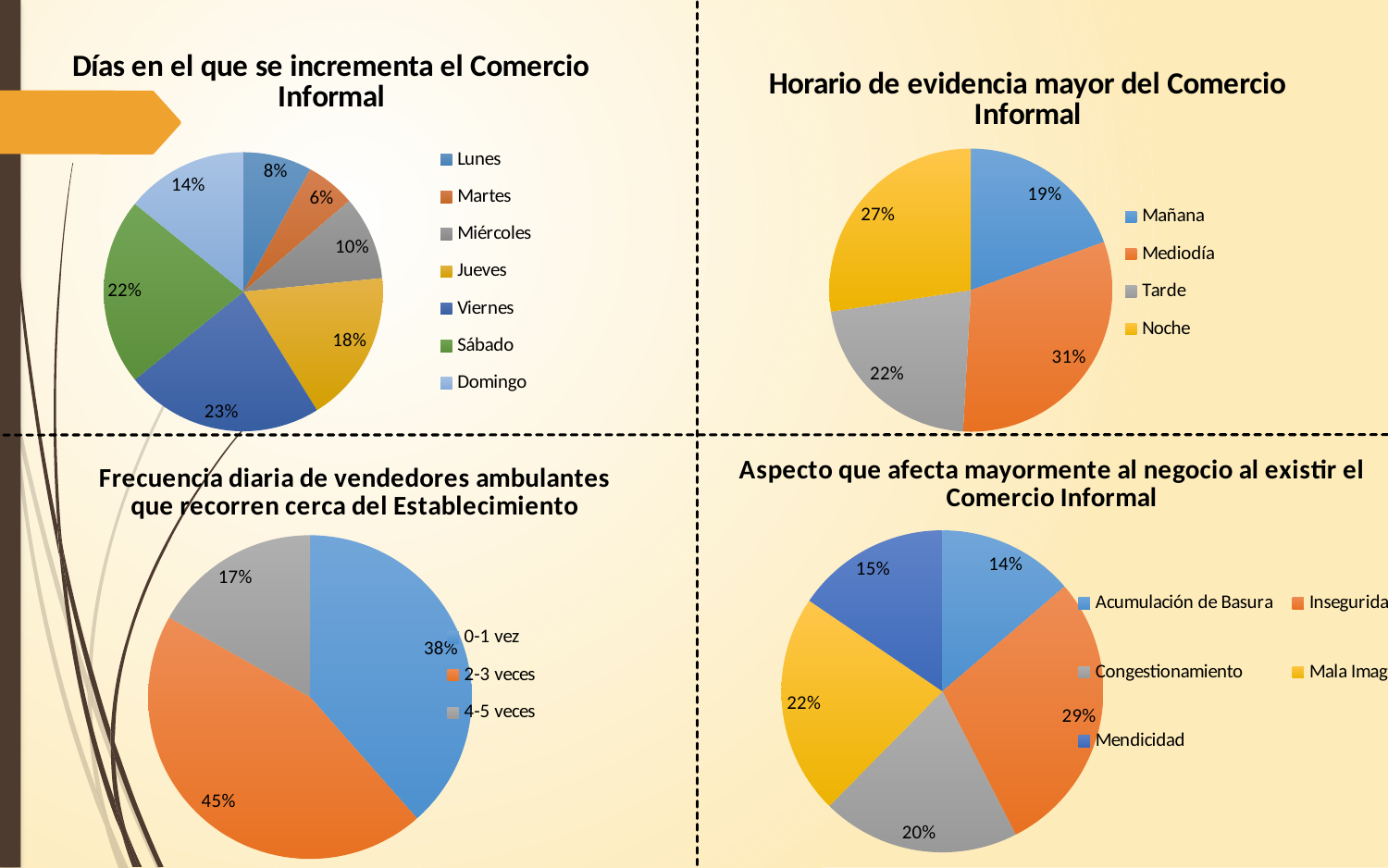
In the chart titled 'Horario de evidencia mayor del Comercio Informal', which is larger, Noche or Tarde? Noche In the chart titled 'Frecuencia diaria de vendedores ambulantes que recorren cerca del Establecimiento', which category has the smallest share? 4-5 veces In the chart titled 'Aspecto que afecta mayormente al negocio al existir el Comercio Informal', what percentage is shown for Congestionamiento? 20% In the chart titled 'Horario de evidencia mayor del Comercio Informal', what percentage is shown for Mediodía? 31% In the chart titled 'Horario de evidencia mayor del Comercio Informal', which time of day has the largest share? Mediodía In the chart titled 'Días en el que se incrementa el Comercio Informal', what percentage is shown for Viernes? 23% In the chart titled 'Días en el que se incrementa el Comercio Informal', which day has the smallest slice? Martes What type of chart is used in 'Frecuencia diaria de vendedores ambulantes que recorren cerca del Establecimiento'? Pie chart In the chart titled 'Días en el que se incrementa el Comercio Informal', how many categories does the legend list? 7 In the chart titled 'Días en el que se incrementa el Comercio Informal', what is the difference between the Jueves and Miércoles percentages? 8% In the chart titled 'Aspecto que afecta mayormente al negocio al existir el Comercio Informal', what is the difference between the Mala Imagen and Mendicidad percentages? 7% In the chart titled 'Frecuencia diaria de vendedores ambulantes que recorren cerca del Establecimiento', what percentage is shown for 2-3 veces? 45%